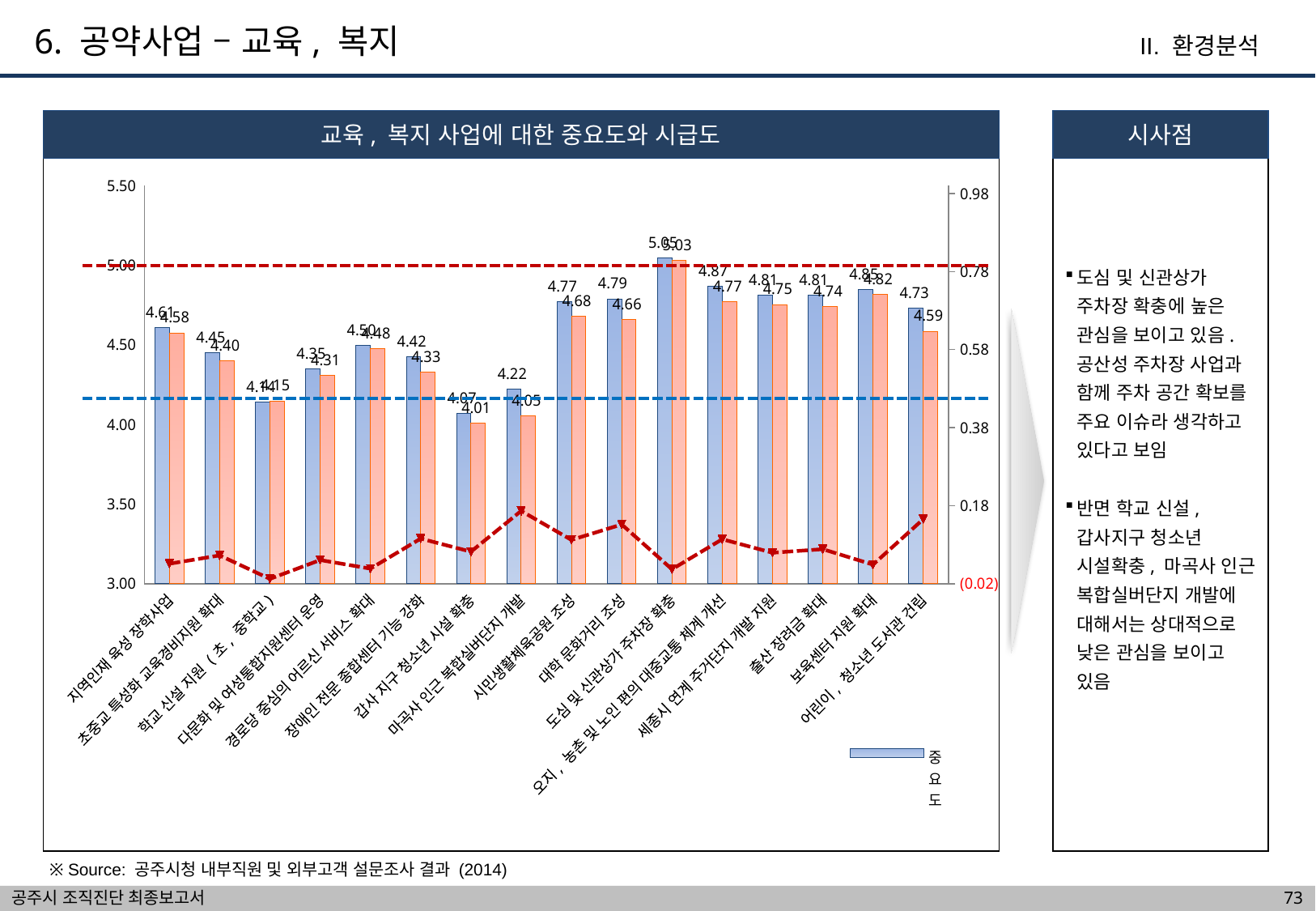
Which has the larger 중요도 (blue bar) value: 보육센터 지원 확대 or 어린이, 청소년 도서관 건립? 보육센터 지원 확대 How many entries does the chart's legend list? 1 What is the 중요도 (blue bar) value for 오지, 농촌 및 노인 편의 대중교통 체계 개선? 4.87 What kind of chart is used to plot the 중요도 series? bar chart What is the title of the chart? 교육, 복지 사업에 대한 중요도와 시급도 How many categories are shown on the x axis of the chart? 16 Which category has the lowest 중요도 (blue bar) value? 갑사 지구 청소년 시설 확충 Is the 중요도 (blue bar) value for 지역인재 육성 장학사업 greater or less than 4.50? greater Which category has the highest 중요도 (blue bar) value? 도심 및 신관상가 주차장 확충 What is the 중요도 (blue bar) value for 마곡사 인근 복합실버단지 개발? 4.22 What is the difference between the highest 중요도 value (5.05) and the lowest 중요도 value (4.07)? 0.98 What is the value of the orange bar for 대학 문화거리 조성? 4.66